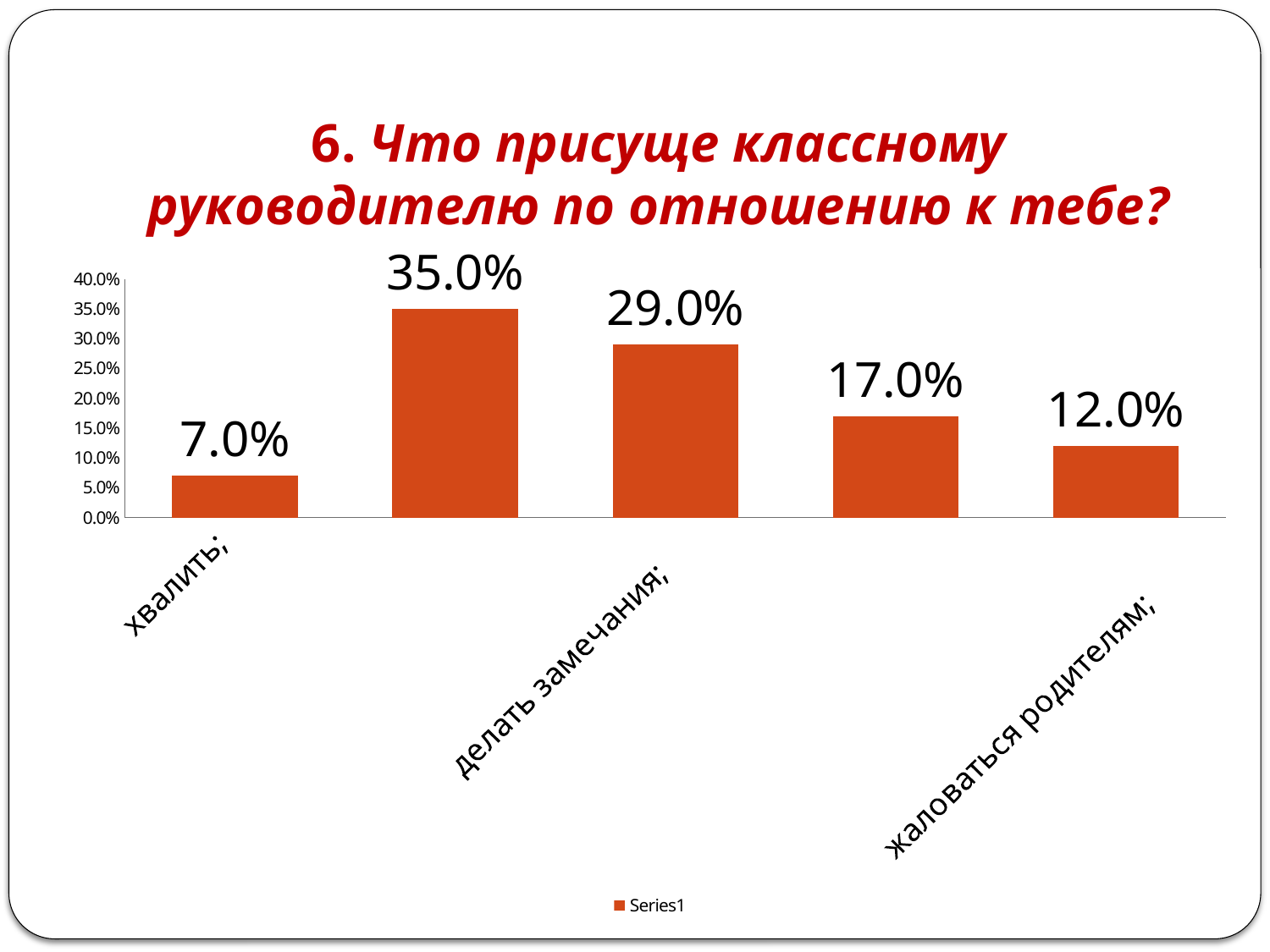
What is the highest value shown on the chart? 35.0% What kind of chart is shown on the slide? bar chart What is the value for "делать замечания;"? 29.0% What is the difference between the values for "делать замечания;" and "хвалить;"? 22.0 percentage points What is the value for "хвалить;"? 7.0% Is the value for "хвалить;" greater or less than 10.0%? less Which is larger, the value for "жаловаться родителям;" or the value for "хвалить;"? жаловаться родителям; Which labelled category has the lowest value? хвалить; How many bars are plotted on the chart? 5 What is the value for "жаловаться родителям;"? 12.0% How many series does the legend list? 1 What is the difference between the values for "делать замечания;" and "жаловаться родителям;"? 17.0 percentage points